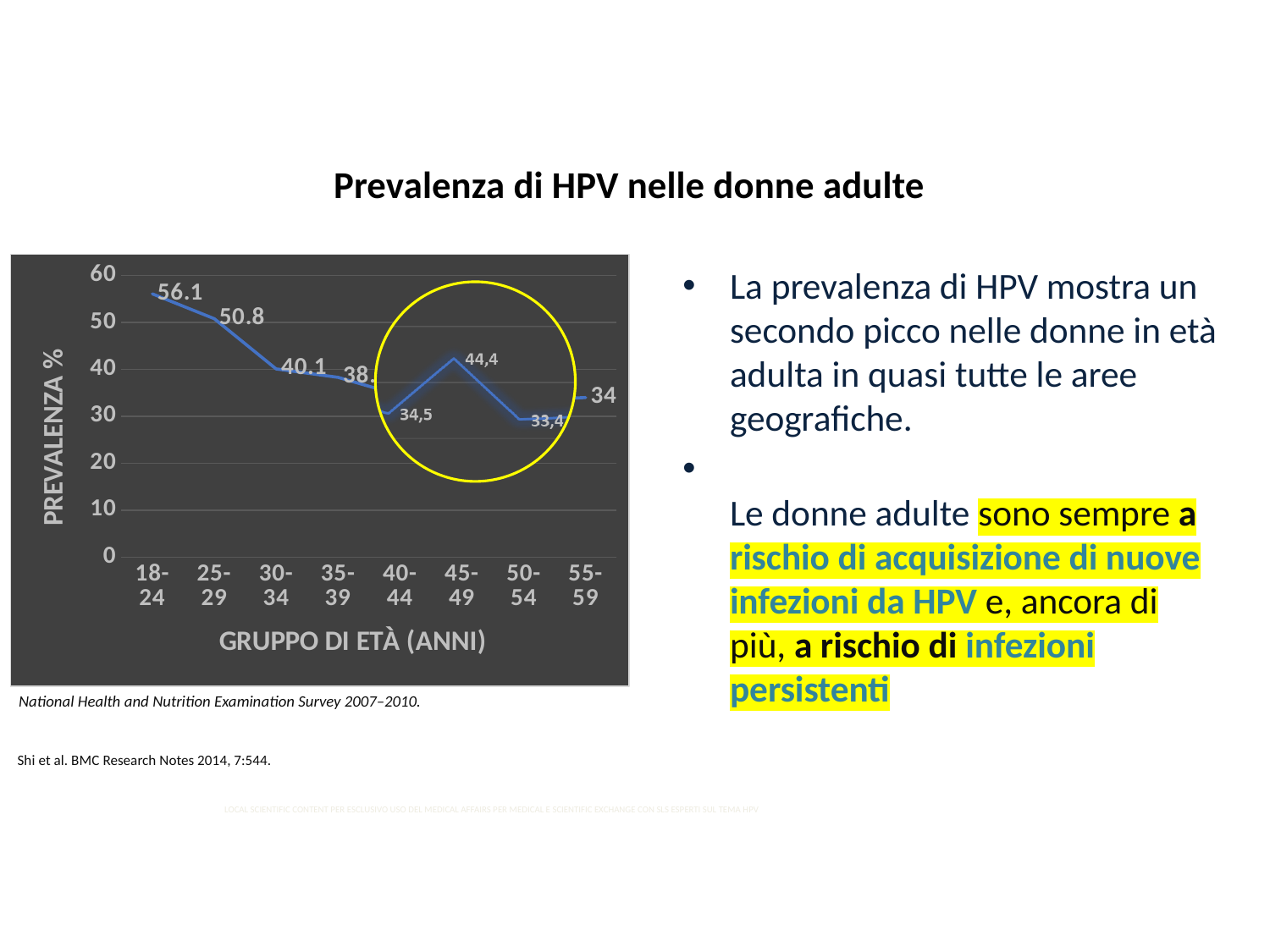
What is the HPV prevalence for the 18-24 age group? 56.1 Which age group has a higher prevalence, 40-44 or 45-49? 45-49 Which age group has the highest HPV prevalence? 18-24 How many age groups are plotted on the x axis? 8 What is the HPV prevalence for the 55-59 age group? 34 What is the title of the x axis? GRUPPO DI ETÀ (ANNI) What is the difference in prevalence between the 18-24 and 25-29 age groups? 5.3 What is the HPV prevalence for the 45-49 age group? 44,4 What is the HPV prevalence for the 50-54 age group? 33,4 Is the value for the 35-39 age group greater or less than 40? less Which age group has the lowest HPV prevalence? 50-54 What kind of chart is shown on the slide? line chart